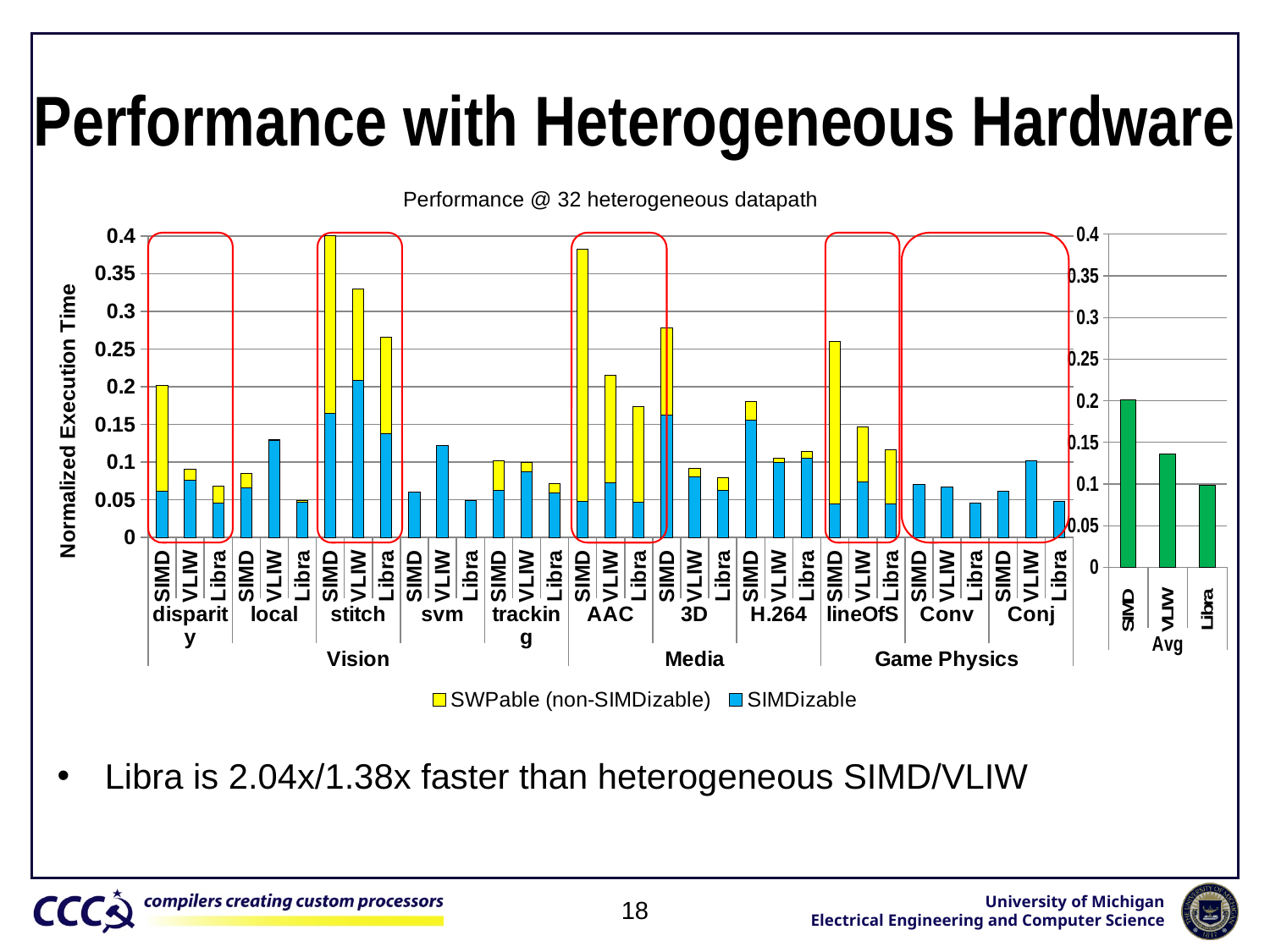
In the main chart 'Performance @ 32 heterogeneous datapath', which is larger, the total for stitch VLIW or stitch Libra? stitch VLIW What kind of chart is the main chart 'Performance @ 32 heterogeneous datapath'? Stacked bar chart In the 'Avg' chart on the right, which bar is the lowest? Libra In the main chart 'Performance @ 32 heterogeneous datapath', is the total value for the AAC SIMD bar greater or less than 0.35? greater In the main chart 'Performance @ 32 heterogeneous datapath', how many series does the legend list? 2 In the main chart 'Performance @ 32 heterogeneous datapath', how many benchmarks are shown along the x axis? 11 In the main chart 'Performance @ 32 heterogeneous datapath', which is larger, the total for AAC SIMD or 3D SIMD? AAC SIMD In the main chart 'Performance @ 32 heterogeneous datapath', is the total value for the stitch VLIW bar greater or less than 0.3? greater In the main chart 'Performance @ 32 heterogeneous datapath', is the total value for the lineOfS SIMD bar greater or less than 0.25? greater In the 'Avg' chart on the right, which bar is the highest? SIMD In the main chart 'Performance @ 32 heterogeneous datapath', what are the two legend entries? SWPable (non-SIMDizable) and SIMDizable